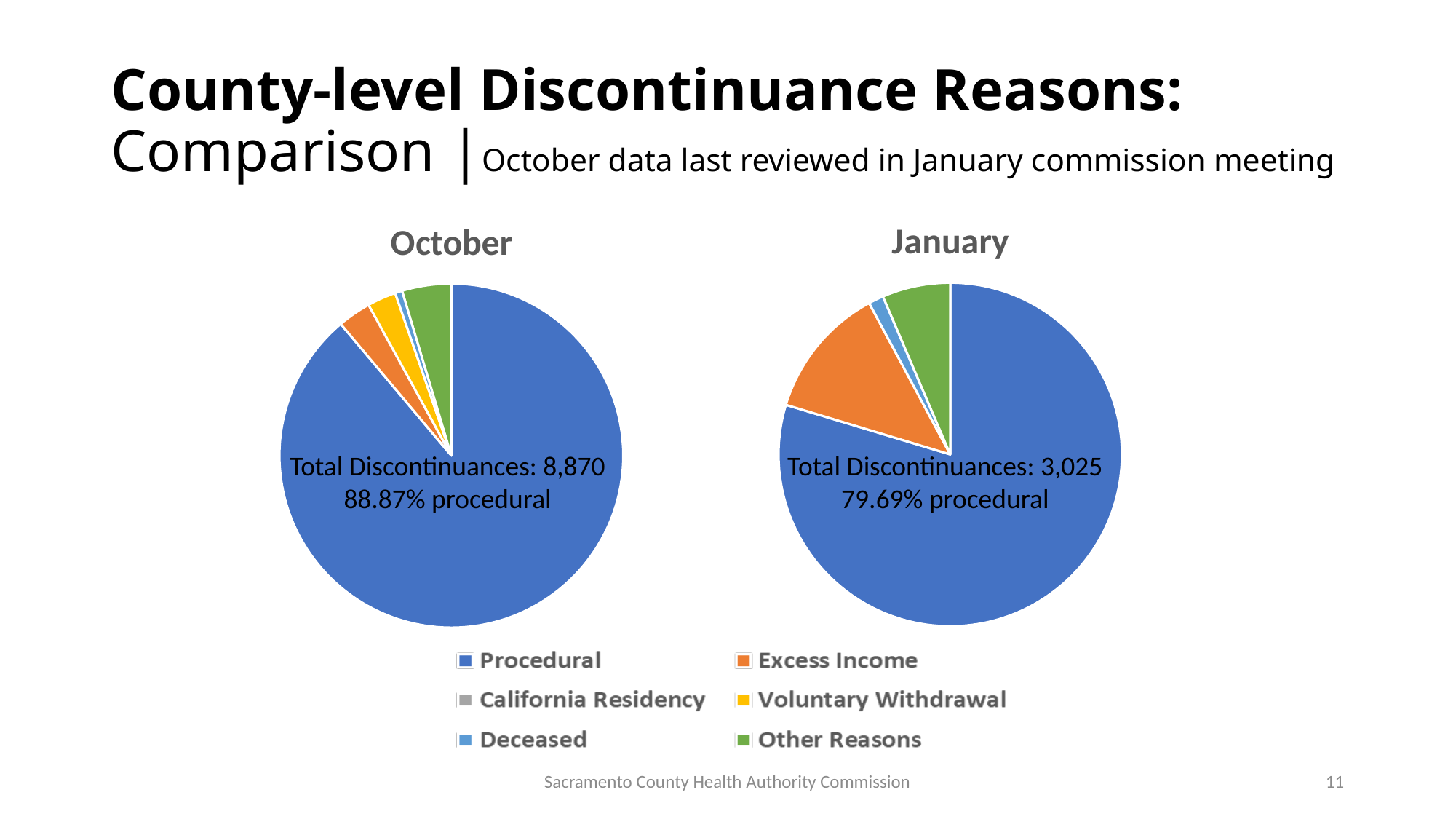
In the January chart, which category has the largest slice? Procedural In the October chart, what share of discontinuances is procedural? 88.87% In the January chart, which slice is larger, Excess Income or Other Reasons? Excess Income What colour represents Procedural in the charts? Blue What is the difference in total discontinuances between the October chart and the January chart? 5,845 In the October chart, which category has the largest slice? Procedural What kind of chart is used for the October data? Pie chart Which chart shows a higher total of discontinuances, October or January? October In the January chart, what share of discontinuances is procedural? 79.69% In the October chart, what is the total number of discontinuances? 8,870 In the January chart, what is the total number of discontinuances? 3,025 How many categories does the legend list? 6